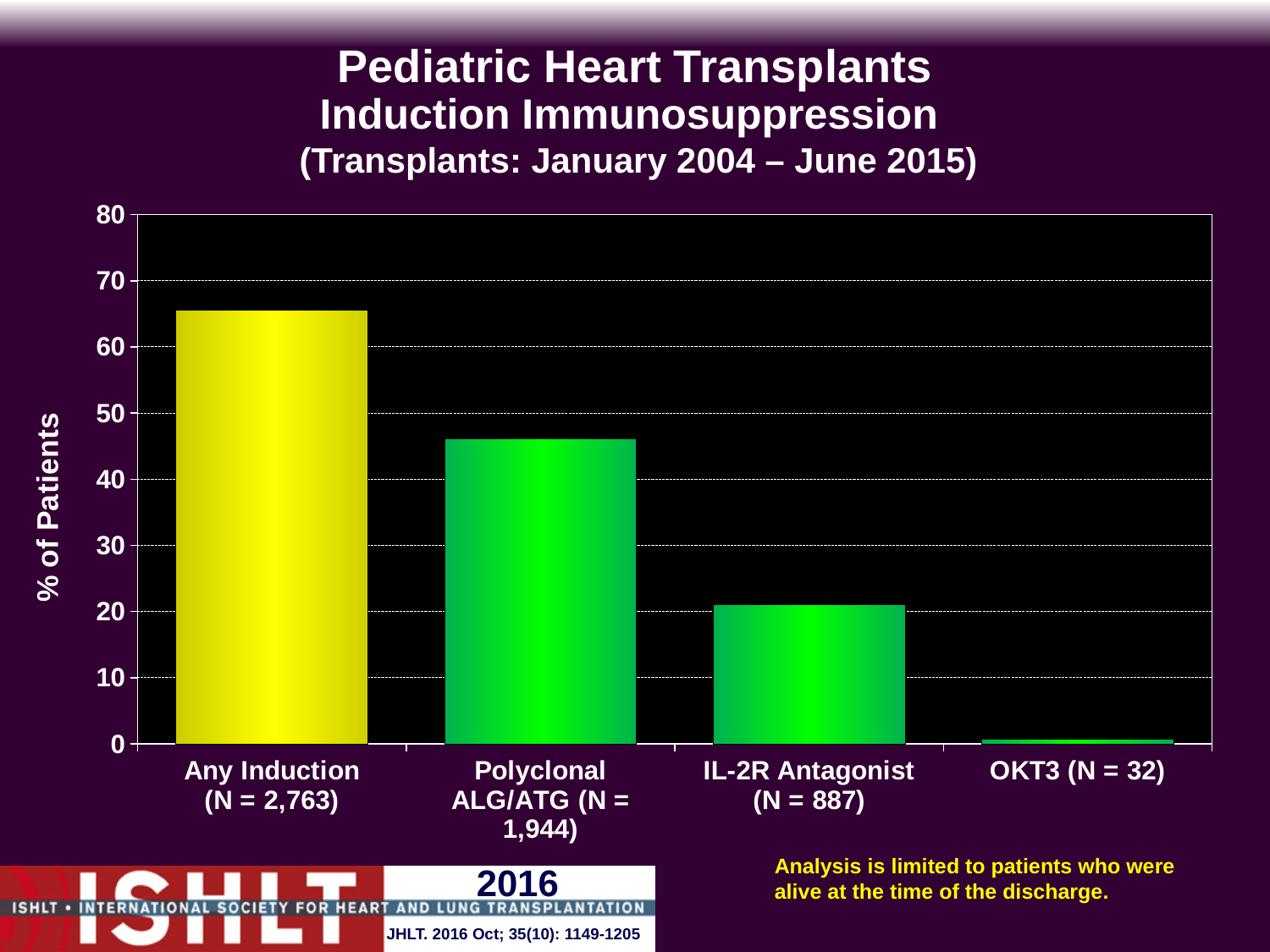
Which category has the highest % of patients? Any Induction (N = 2,763) Which is larger, the value for Polyclonal ALG/ATG or the value for IL-2R Antagonist? Polyclonal ALG/ATG What kind of chart is shown on the slide? bar chart Which category has the lowest % of patients? OKT3 (N = 32) Is the value for Any Induction greater or less than 70? less How many categories are shown on the x axis of the chart? 4 Do the bar values rise or fall from left to right along the x axis? fall Is the value for IL-2R Antagonist greater or less than 30? less Is the value for Polyclonal ALG/ATG greater or less than 40? greater What is the label of the y axis? % of Patients